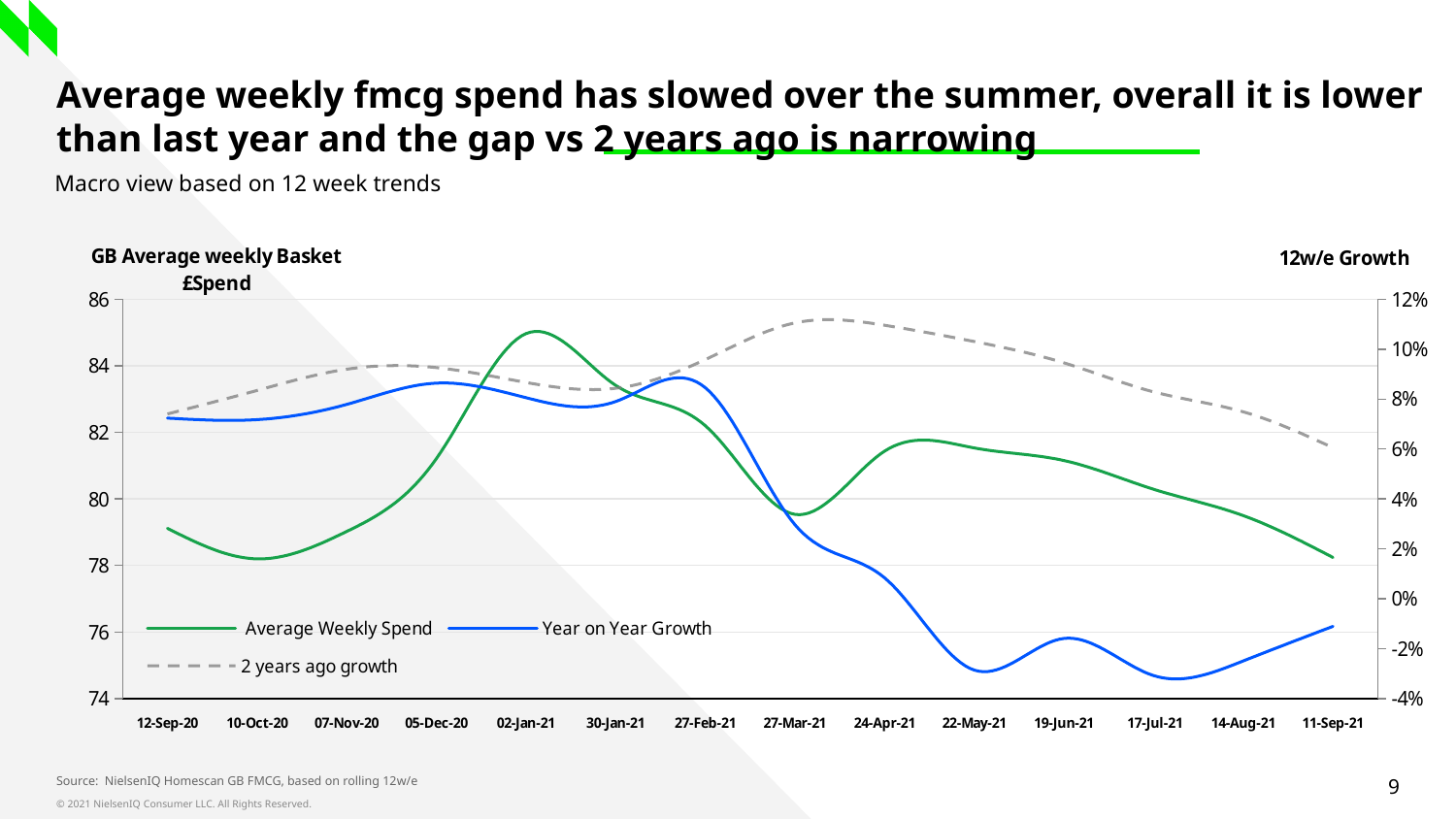
Is the Average Weekly Spend value at 02-Jan-21 greater or less than 84? greater What kind of chart is shown on the slide? line chart What is the title of the right-hand axis of the chart? 12w/e Growth At which date does the Average Weekly Spend line reach its highest point? 02-Jan-21 At which date does the 2 years ago growth line reach its highest point? 27-Mar-21 How many series does the chart legend list? 3 Is the Average Weekly Spend value at 12-Sep-20 greater or less than 80? less How many dates are labelled along the x axis of the chart? 14 Is the 2 years ago growth value at 11-Sep-21 greater or less than 8%? less Does the Average Weekly Spend line rise or fall between 24-Apr-21 and 11-Sep-21? fall At 27-Mar-21, which is higher: Year on Year Growth or 2 years ago growth? 2 years ago growth